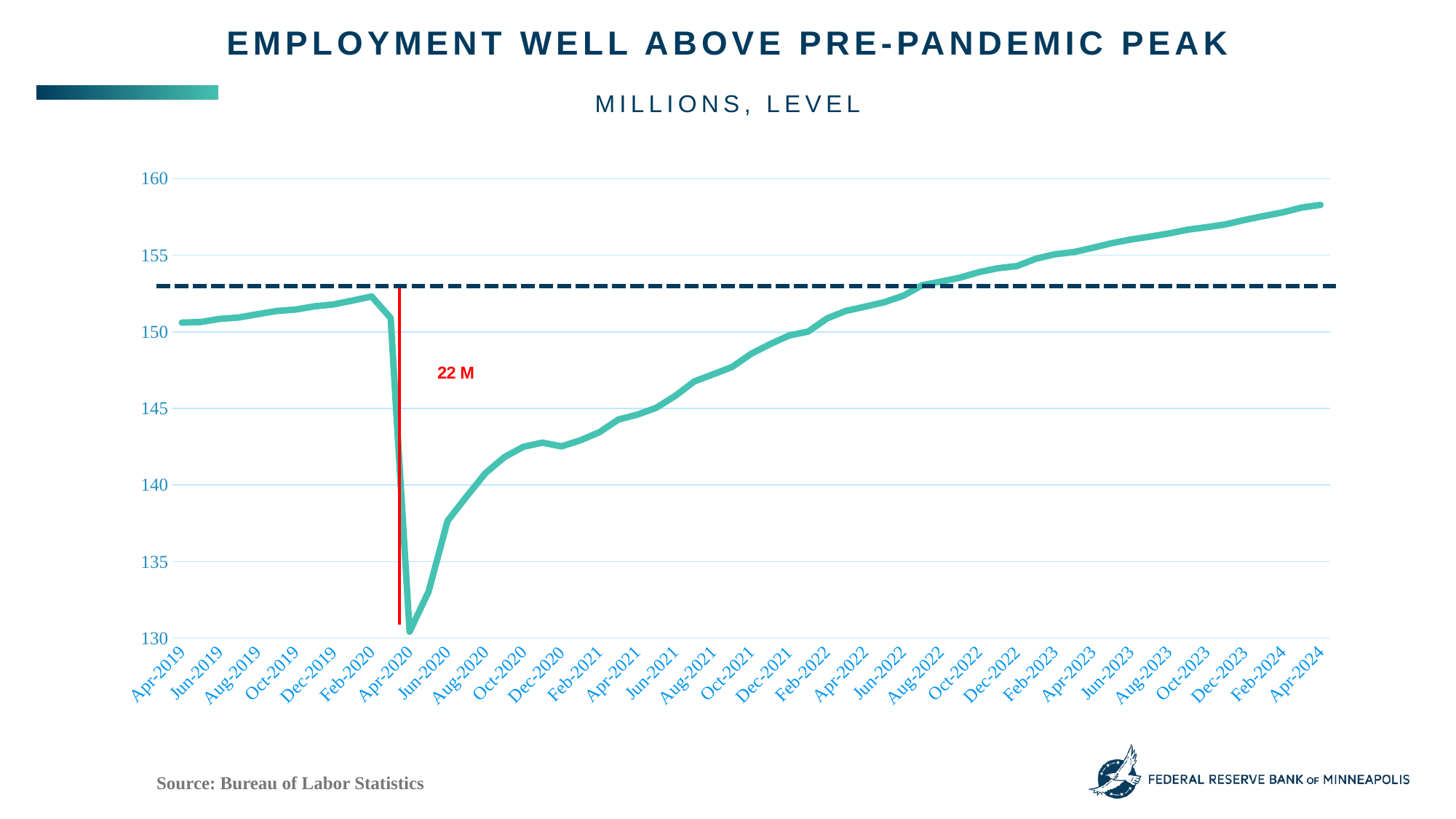
Is the value for Apr-2024 greater or less than 155? greater What value is printed in red next to the vertical red line marking the drop in 2020? 22 M Is the value for Apr-2019 greater or less than 150? greater From Apr-2020 to Apr-2024, does the employment line rise or fall? rise Which is larger, the value for Jun-2020 or the value for Jun-2021? Jun-2021 What kind of chart is shown on the slide? line chart Is the value for Dec-2020 greater or less than 145? less Which is larger, the value for Feb-2020 or the value for Apr-2024? Apr-2024 What is the title of the chart? EMPLOYMENT WELL ABOVE PRE-PANDEMIC PEAK In which month does the employment line reach its highest point? Apr-2024 In which month does the employment line reach its lowest point? Apr-2020